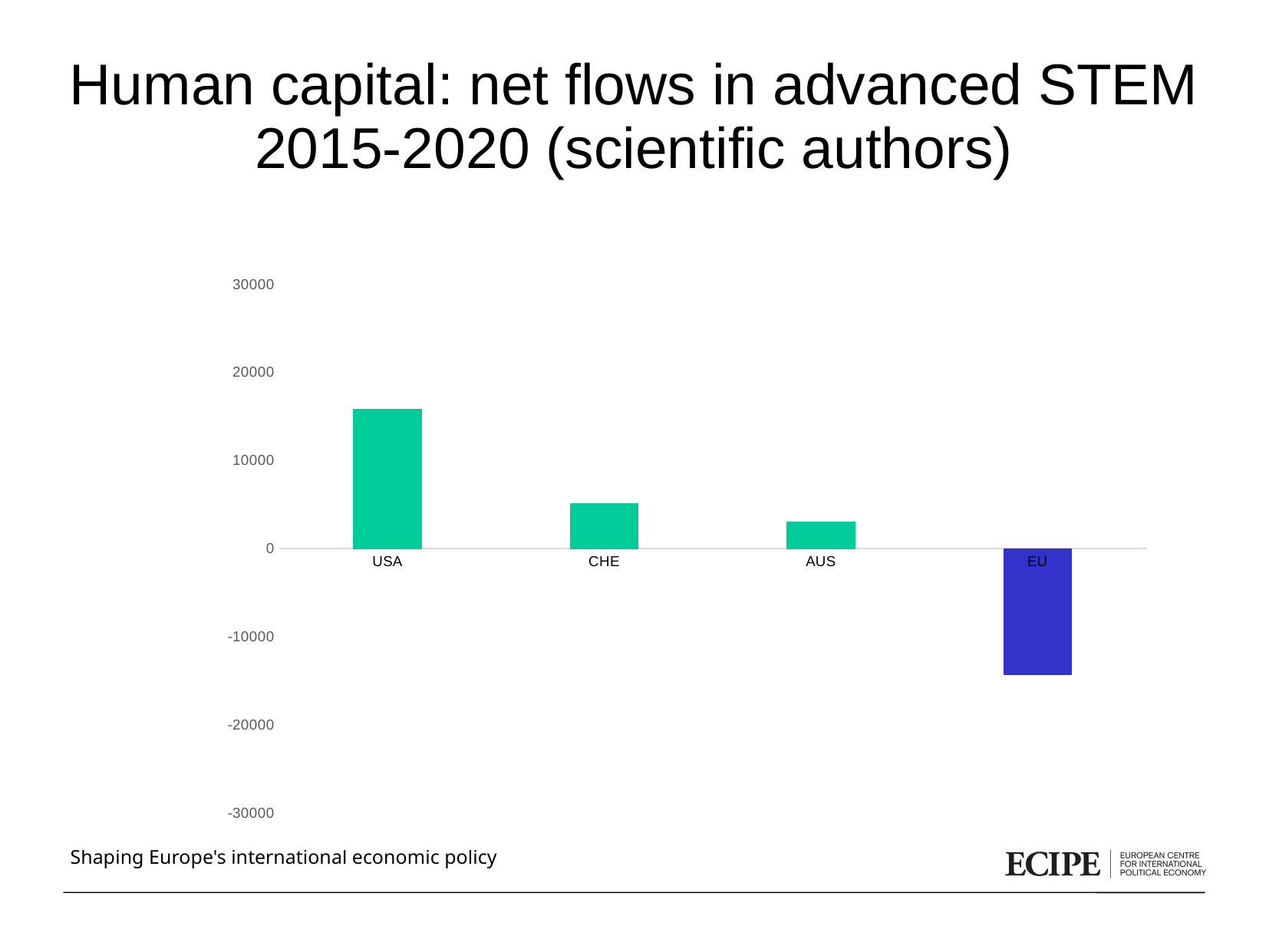
Which category has the lowest value? EU Is the value for EU greater or less than -10000? less Is the value for USA greater or less than 10000? greater Do the values rise or fall moving from left to right across the categories? fall Is the value for CHE greater or less than 10000? less Which is larger, the value for USA or the value for CHE? USA Which is larger, the value for CHE or the value for AUS? CHE Which category has the highest value? USA How many categories are plotted on the chart? 4 Which category is shown with a bar of a different colour (blue) from the others? EU What kind of chart is shown on the slide? bar chart